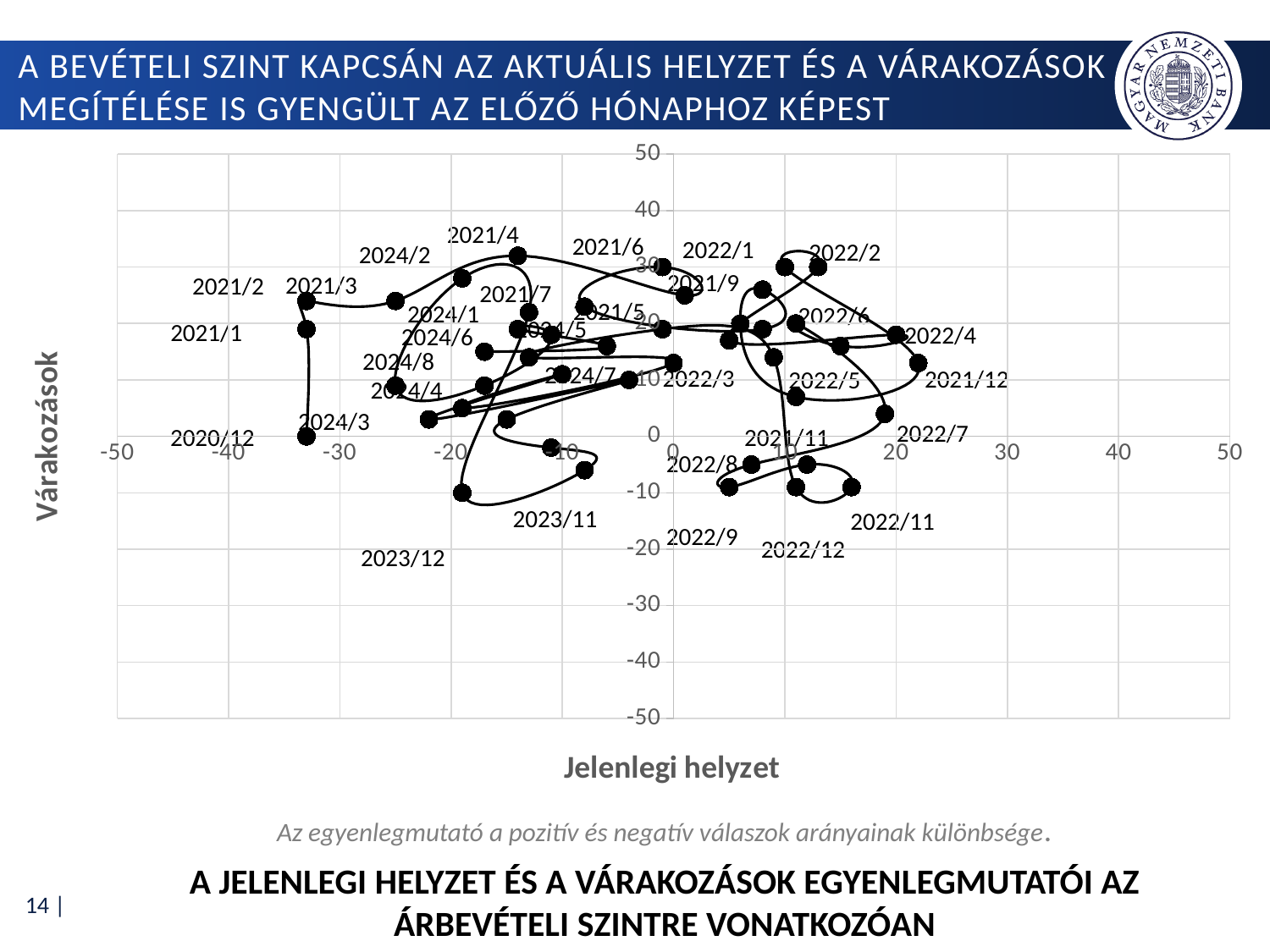
What is the title of the vertical axis of the chart? Várakozások Is the Jelenlegi helyzet value for the point labelled 2020/12 greater or less than -20? less Is the Várakozások value for the point labelled 2021/4 greater or less than 20? greater Is the Várakozások value for the point labelled 2023/11 greater or less than 0? less What kind of chart is shown on the slide? scatter chart What is the title of the horizontal axis of the chart? Jelenlegi helyzet